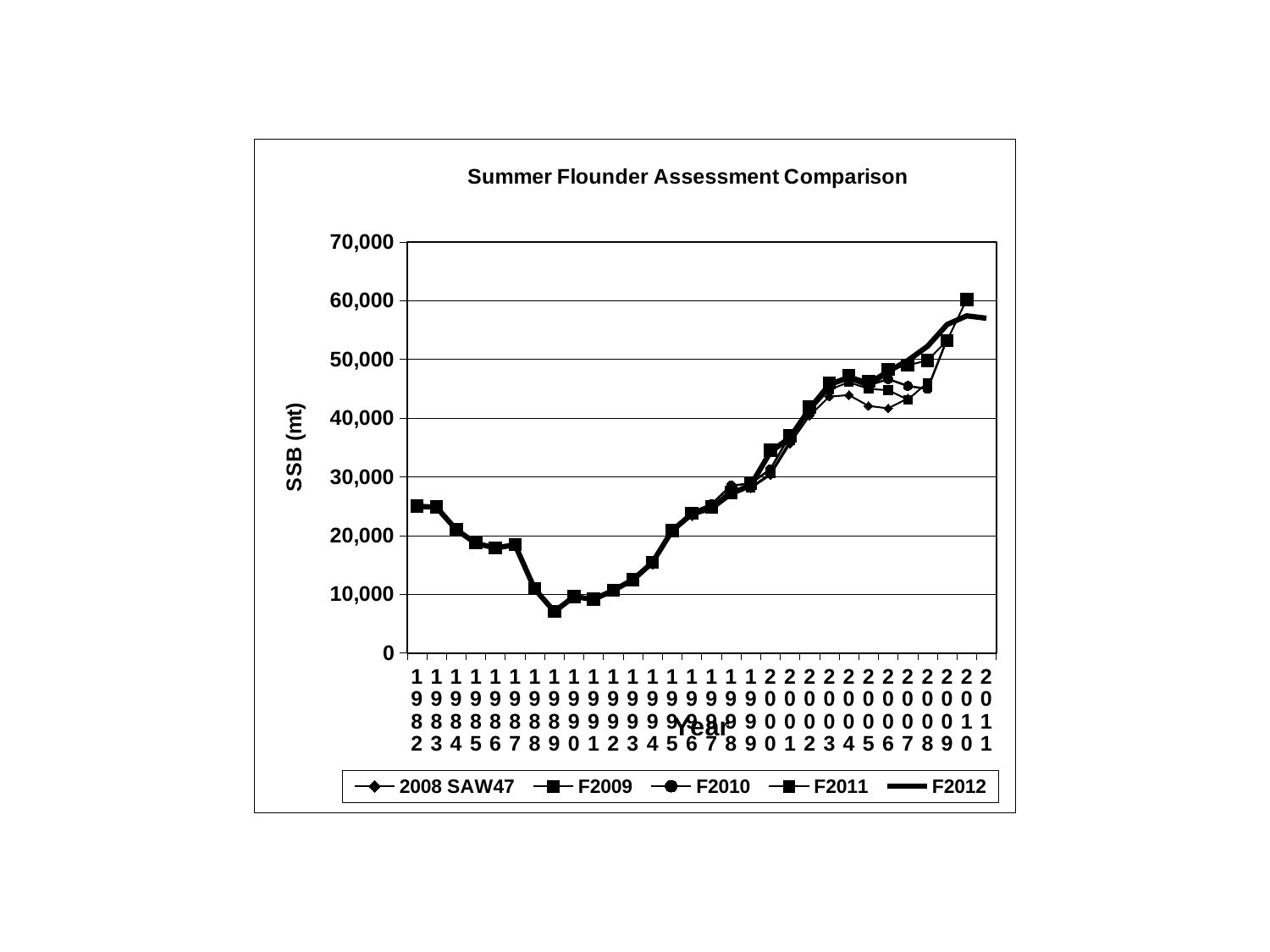
Do the SSB values rise or fall from 1989 to 2010? rise What is the title of the chart? Summer Flounder Assessment Comparison Is the F2011 SSB value in 2010 greater or less than 50,000? greater In which year does the F2011 series reach its highest SSB value? 2010 How many series does the legend list? 5 How many years are shown along the x axis? 30 Do the SSB values rise or fall from 1982 to 1989? fall What is the label of the y axis? SSB (mt) What type of chart is shown on the slide? Line chart Is the SSB value in 1982 greater or less than 20,000? greater In which year do the series reach their lowest SSB value? 1989 Is the SSB value in 1989 greater or less than 10,000? less